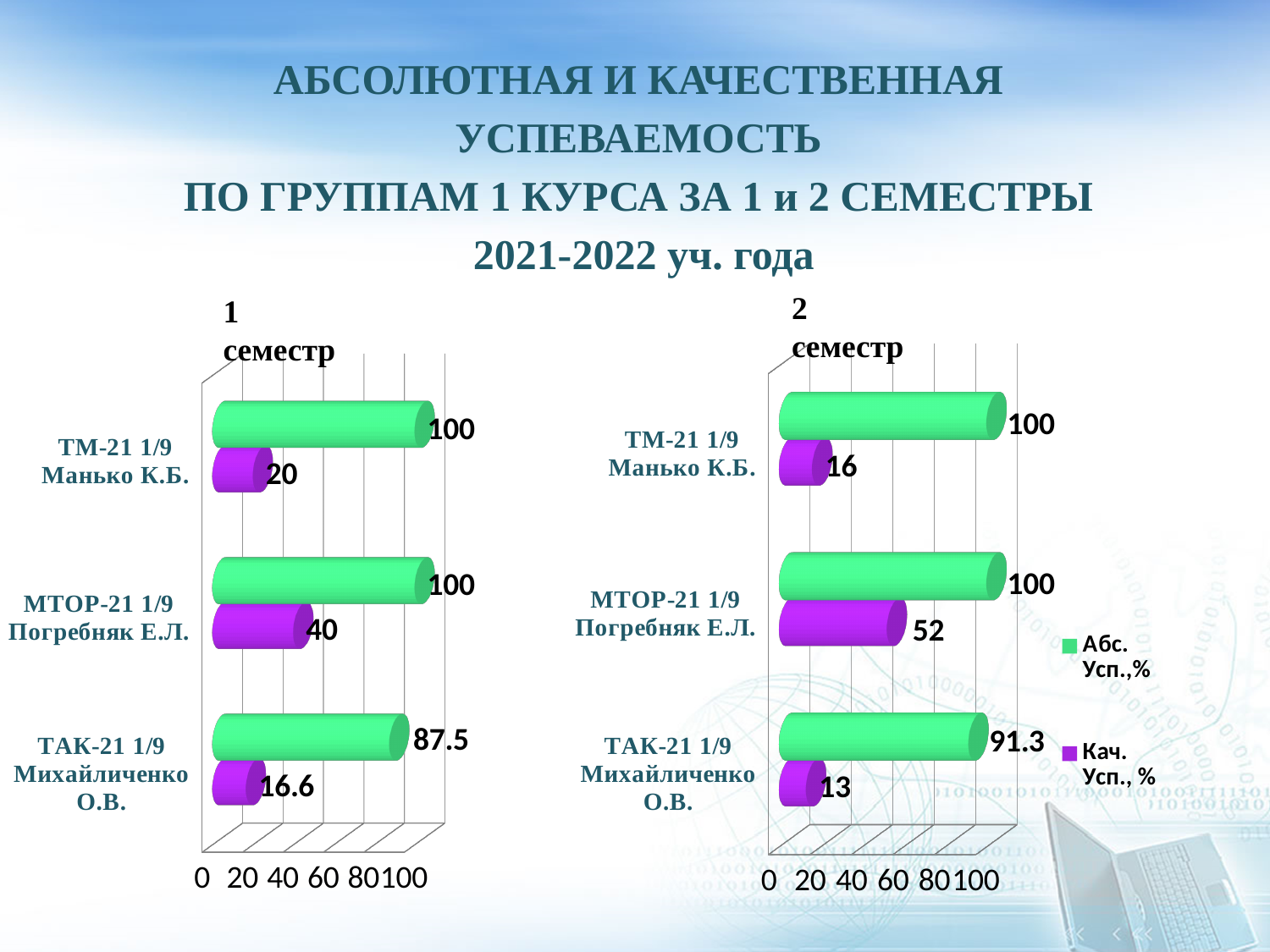
In the "2 семестр" chart, what is the Кач. Усп., % value for ТМ-21 1/9 Манько К.Б.? 16 In the "1 семестр" chart, what is the Кач. Усп., % value for МТОР-21 1/9 Погребняк Е.Л.? 40 Which is larger: the Кач. Усп., % value for ТМ-21 1/9 Манько К.Б. in the "1 семестр" chart or in the "2 семестр" chart? 1 семестр How many series does the legend list? 2 In the "2 семестр" chart, what colour are the Кач. Усп., % bars? Purple What type of chart is the "2 семестр" chart? Bar chart In the "2 семестр" chart, which group has the highest Кач. Усп., % value? МТОР-21 1/9 Погребняк Е.Л. In the "1 семестр" chart, how many groups are shown? 3 In the "2 семестр" chart, what is the Абс. Усп.,% value for ТАК-21 1/9 Михайличенко О.В.? 91.3 In the "1 семестр" chart, which group has the lowest Кач. Усп., % value? ТАК-21 1/9 Михайличенко О.В. In the "2 семестр" chart, what is the difference between the Абс. Усп.,% and Кач. Усп., % values for МТОР-21 1/9 Погребняк Е.Л.? 48 In the "1 семестр" chart, what is the Абс. Усп.,% value for ТАК-21 1/9 Михайличенко О.В.? 87.5